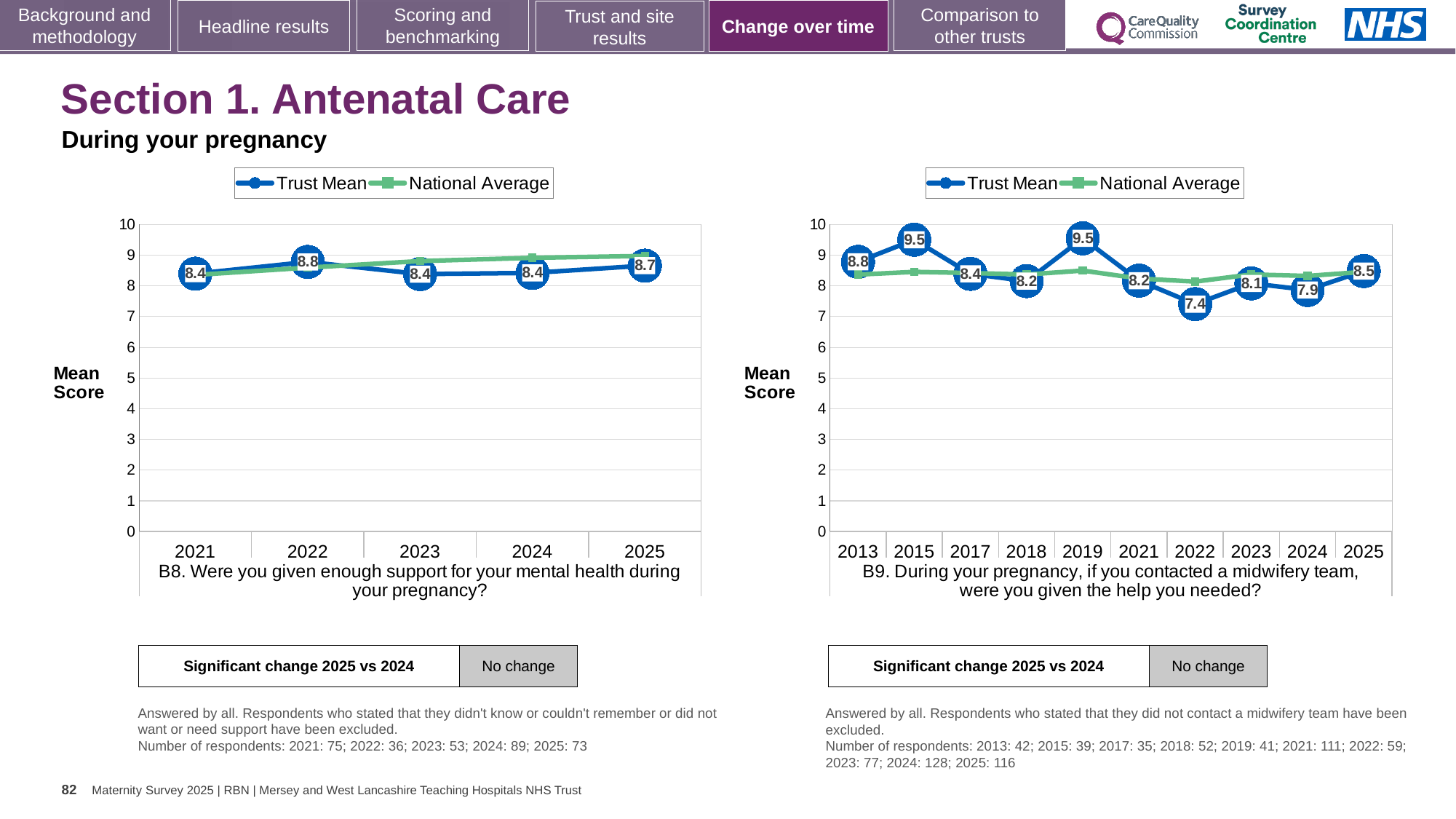
In the B9 chart on the right, what is the Trust Mean for 2022? 7.4 In the B9 chart on the right, what is the Trust Mean for 2019? 9.5 In the B8 chart on the left, which year has the highest Trust Mean? 2022 In the B8 chart on the left, what is the Trust Mean for 2025? 8.7 In the B9 chart on the right, is the Trust Mean higher in 2013 or in 2024? 2013 In the B9 chart on the right, how many years are shown on the x axis? 10 In the B9 chart on the right, which year has the lowest Trust Mean? 2022 In the B8 chart on the left, what is the Trust Mean for 2022? 8.8 In the B8 chart on the left, what is the difference between the Trust Mean for 2022 and 2023? 0.4 How many series does the legend of the B8 chart on the left list? 2 In the B8 chart on the left, how many years are shown on the x axis? 5 In the B9 chart on the right, what is the difference between the Trust Mean for 2015 and 2022? 2.1